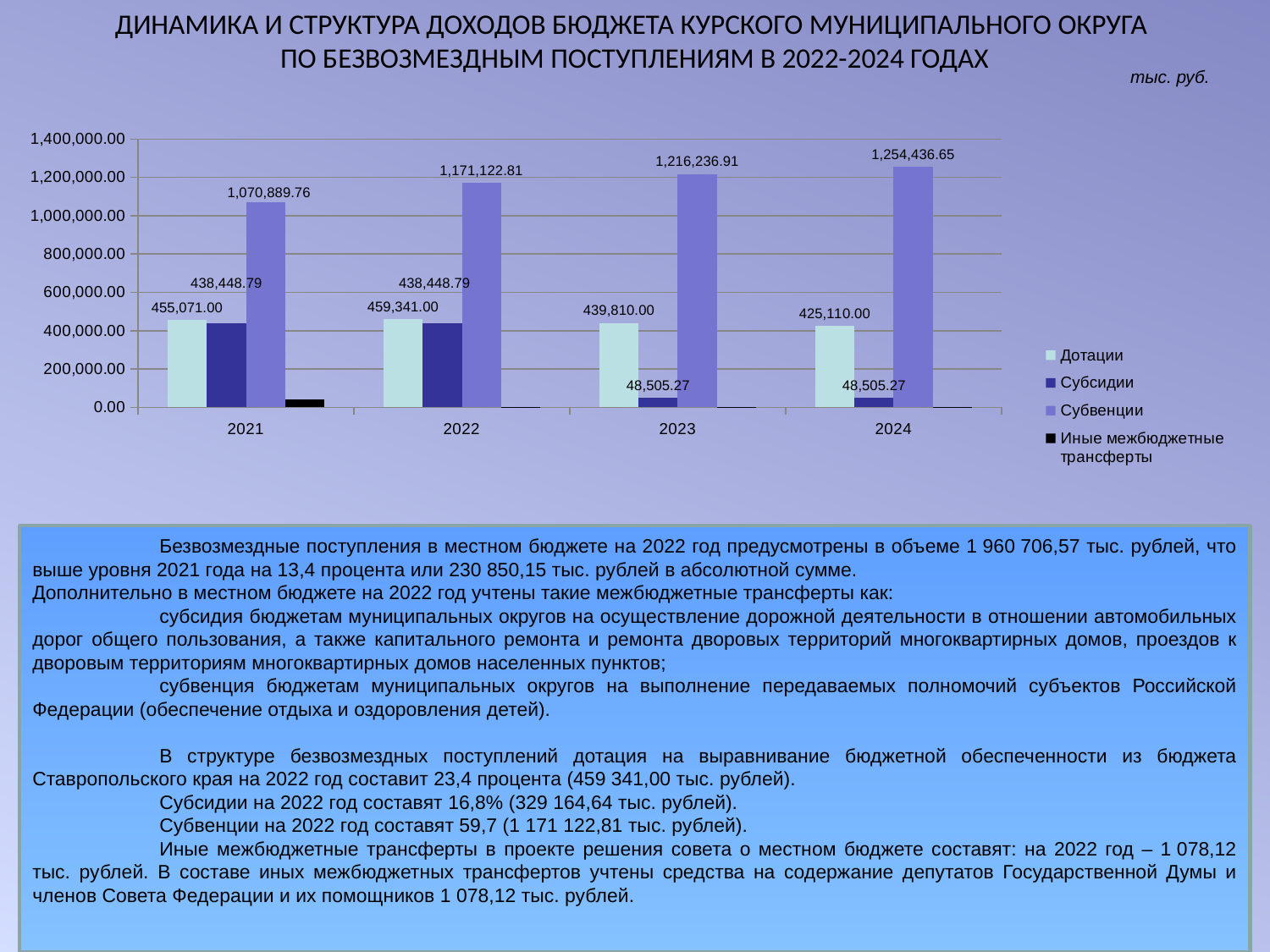
Is the value of Субсидии for 2024 greater or less than 200,000.00? less What is the difference between the Дотации values for 2022 and 2021? 4,270.00 What is the value of Субвенции for 2022? 1,171,122.81 What is the value of Субсидии for 2023? 48,505.27 How many years are shown on the x axis of the chart? 4 In which year is the value of Дотации the lowest? 2024 What is the difference between the Субвенции values for 2024 and 2023? 38,199.74 Which is larger in 2021: Дотации or Субсидии? Дотации Do the values of Субвенции rise or fall from 2021 to 2024? rise In which year is the value of Субвенции the highest? 2024 How many series does the chart legend list? 4 What is the value of Дотации for 2024? 425,110.00